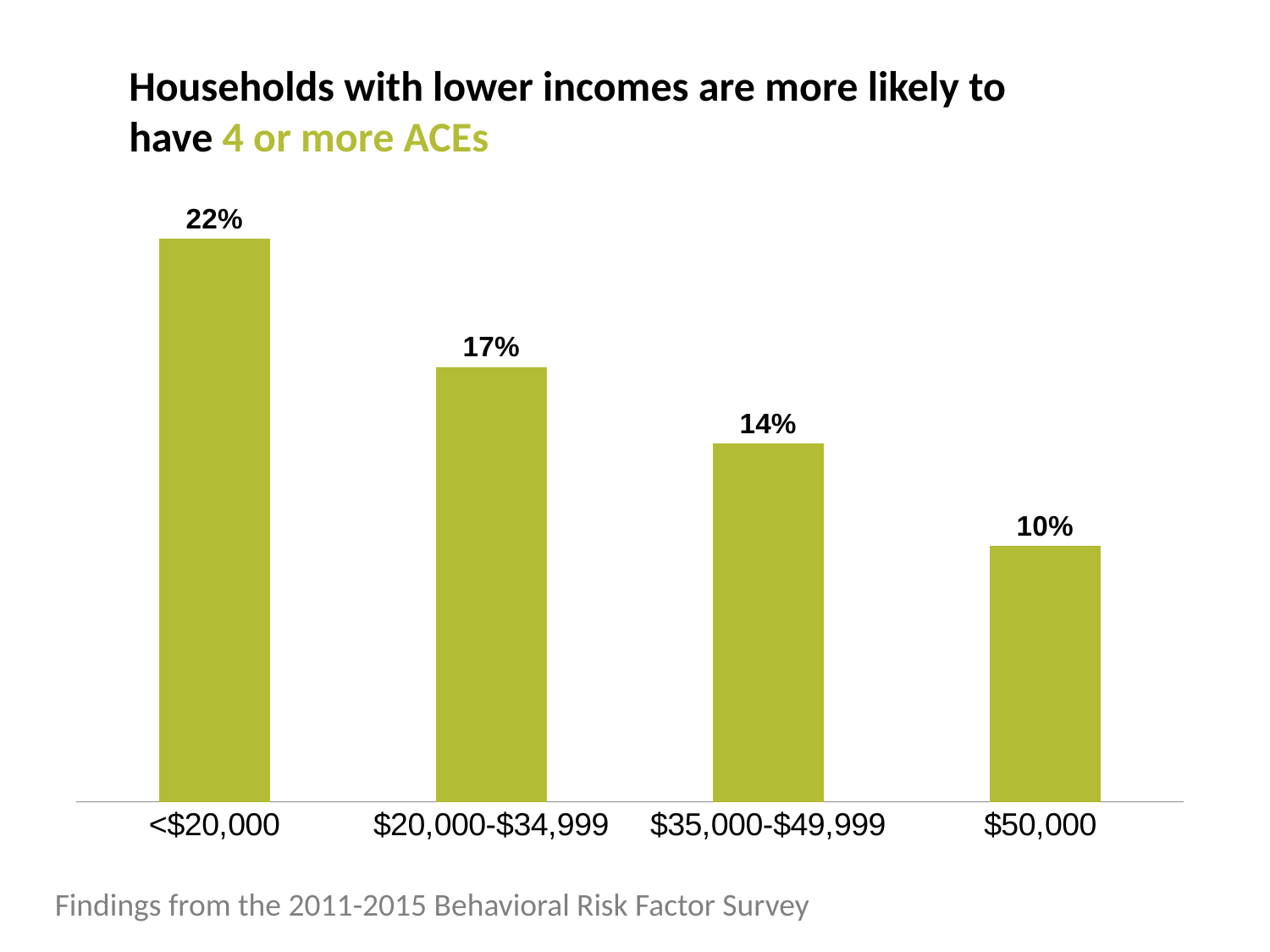
What percentage of households with income <$20,000 have 4 or more ACEs? 22% What is the value shown for the $35,000-$49,999 income group? 14% Do the values rise or fall as income increases along the x axis? Fall What is the value shown for the $50,000 income group? 10% How many income categories are shown in the chart? 4 Which income group has the lowest percentage with 4 or more ACEs? $50,000 What kind of chart is shown on the slide? Bar chart Which is larger, the value for $20,000-$34,999 or the value for $35,000-$49,999? $20,000-$34,999 What is the difference in percentage points between the <$20,000 group and the $50,000 group? 12 What is the value shown for the $20,000-$34,999 income group? 17% Which income group has the highest percentage with 4 or more ACEs? <$20,000 What is the difference in percentage points between the $20,000-$34,999 group and the $35,000-$49,999 group? 3